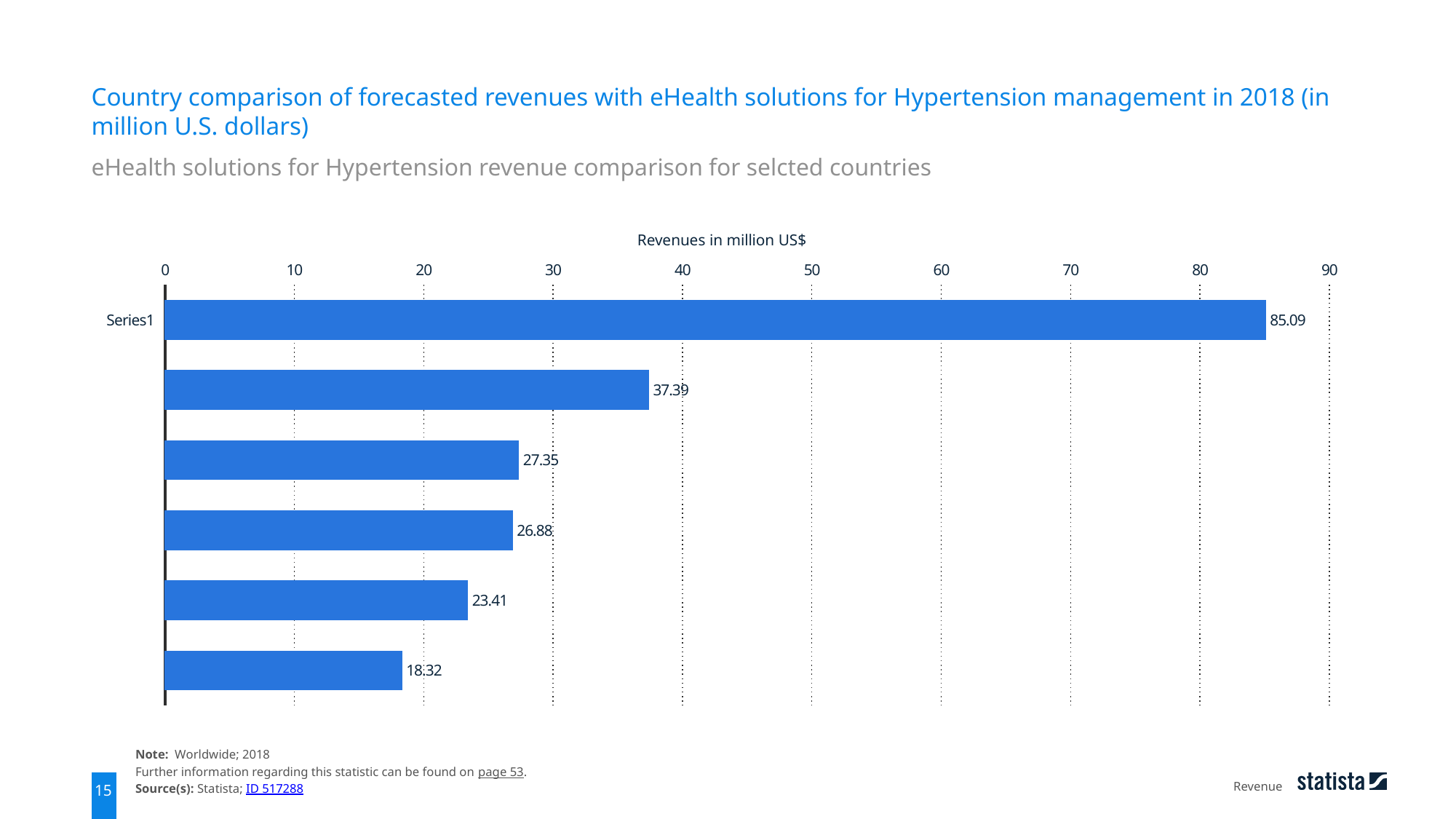
What is the value shown on the second bar from the top? 37.39 What is the difference between the top bar (85.09) and the second bar (37.39)? 47.70 Which is larger, the value of the fifth bar from the top or the bottom bar? the fifth bar (23.41) What kind of chart is shown on the slide? bar chart What is the value shown on the bottom bar of the chart? 18.32 What is the value shown on the top bar of the chart? 85.09 Do the bar values increase or decrease from the top of the chart to the bottom? decrease How many bars are plotted in the chart? 6 What is the value of the shortest bar in the chart? 18.32 What is the difference between the third bar (27.35) and the fourth bar (26.88)? 0.47 What is the value of the longest bar in the chart? 85.09 What is the title of the horizontal axis of the chart? Revenues in million US$